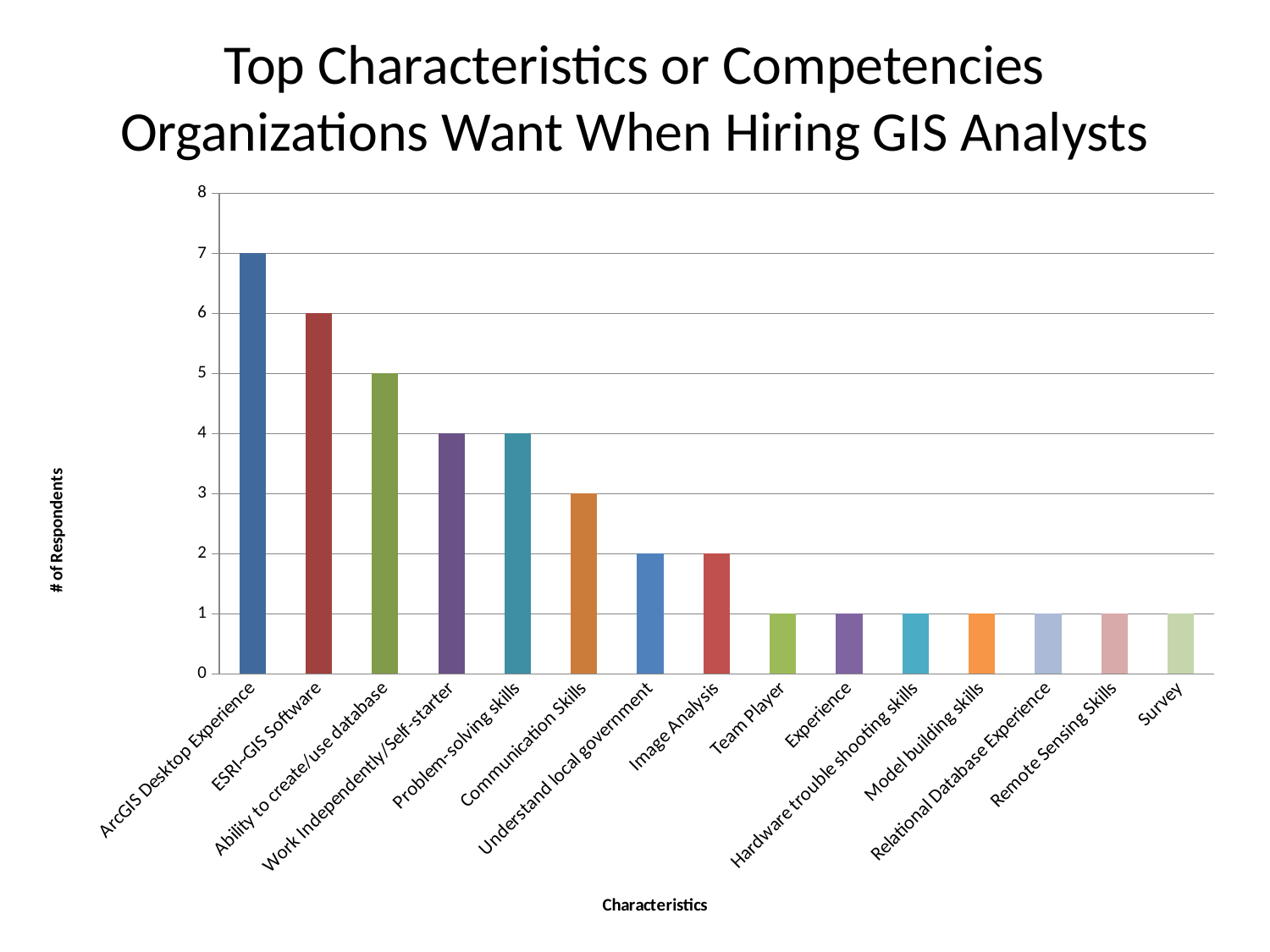
What is the number of respondents for ArcGIS Desktop Experience? 7 Which has more respondents, Problem-solving skills or Image Analysis? Problem-solving skills Which characteristic has the highest number of respondents? ArcGIS Desktop Experience Do the values rise or fall moving from left to right along the x axis? Fall How many characteristics are shown on the x axis? 15 What is the number of respondents for Ability to create/use database? 5 What is the title of the chart? Top Characteristics or Competencies Organizations Want When Hiring GIS Analysts What is the number of respondents for Communication Skills? 3 What is the difference in number of respondents between ESRI-GIS Software and Understand local government? 4 Is the value for ESRI-GIS Software greater or less than 5? greater What is the label of the y axis? # of Respondents What kind of chart is shown on the slide? Bar chart